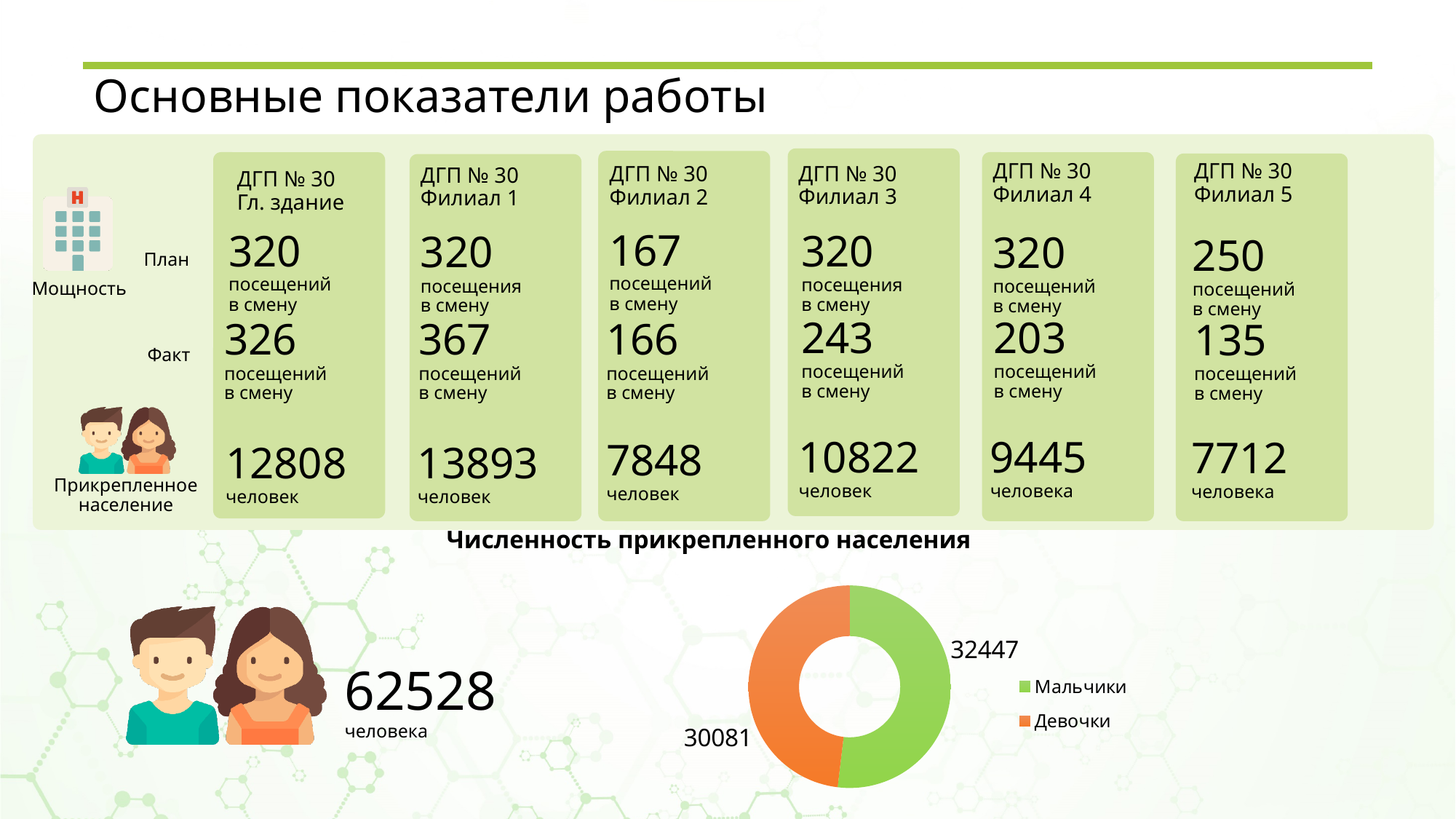
How many entries does the legend of the donut chart list? 2 What is the difference between the Мальчики and Девочки values in the donut chart? 2366 Which slice of the donut chart is the largest? Мальчики In the donut chart, what is the value for Мальчики? 32447 What is the total of the two slices in the donut chart? 62528 What colour is the Девочки slice in the donut chart? Orange In the donut chart, what is the value for Девочки? 30081 Which slice of the donut chart is the smallest? Девочки What share of the donut chart does the Мальчики slice represent? 51.9% How many slices does the donut chart have? 2 In the donut chart, which is larger: Мальчики or Девочки? Мальчики What kind of chart is shown under the heading "Численность прикрепленного населения"? Pie (donut) chart